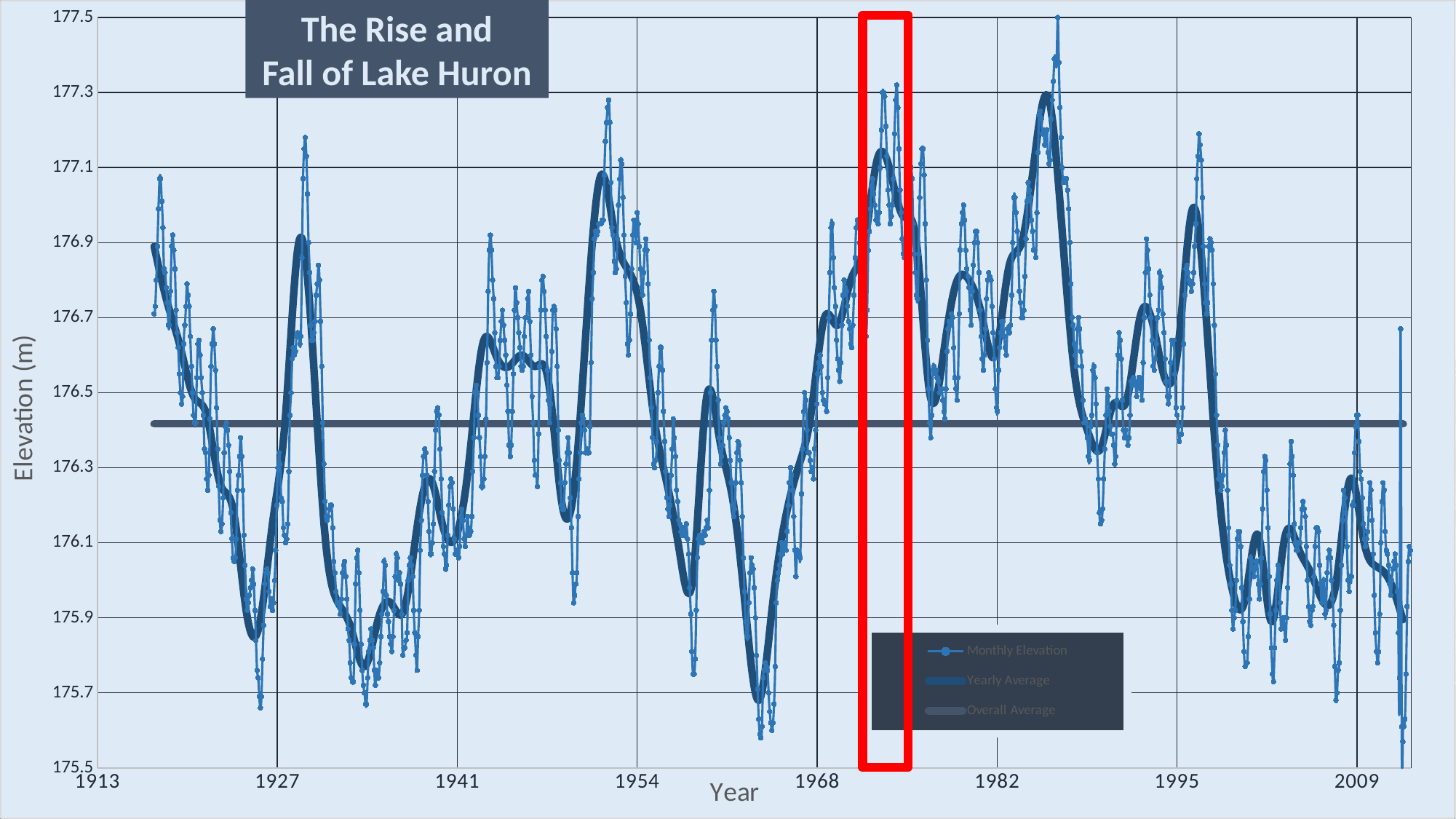
Is the Overall Average line greater or less than 176.3? greater Which is higher: the Yearly Average peak around 1986 or the Yearly Average peak around 1929? the peak around 1986 Does the Yearly Average rise or fall overall between 1986 and 2009? fall What is the title of the chart? The Rise and Fall of Lake Huron Is the Yearly Average at 1941 greater or less than 176.3? less What kind of chart is shown on the slide? line chart Is the lowest point of the Yearly Average around 1964 greater or less than 175.9? less How many series does the legend list? 3 What are the three series named in the legend? Monthly Elevation, Yearly Average, Overall Average